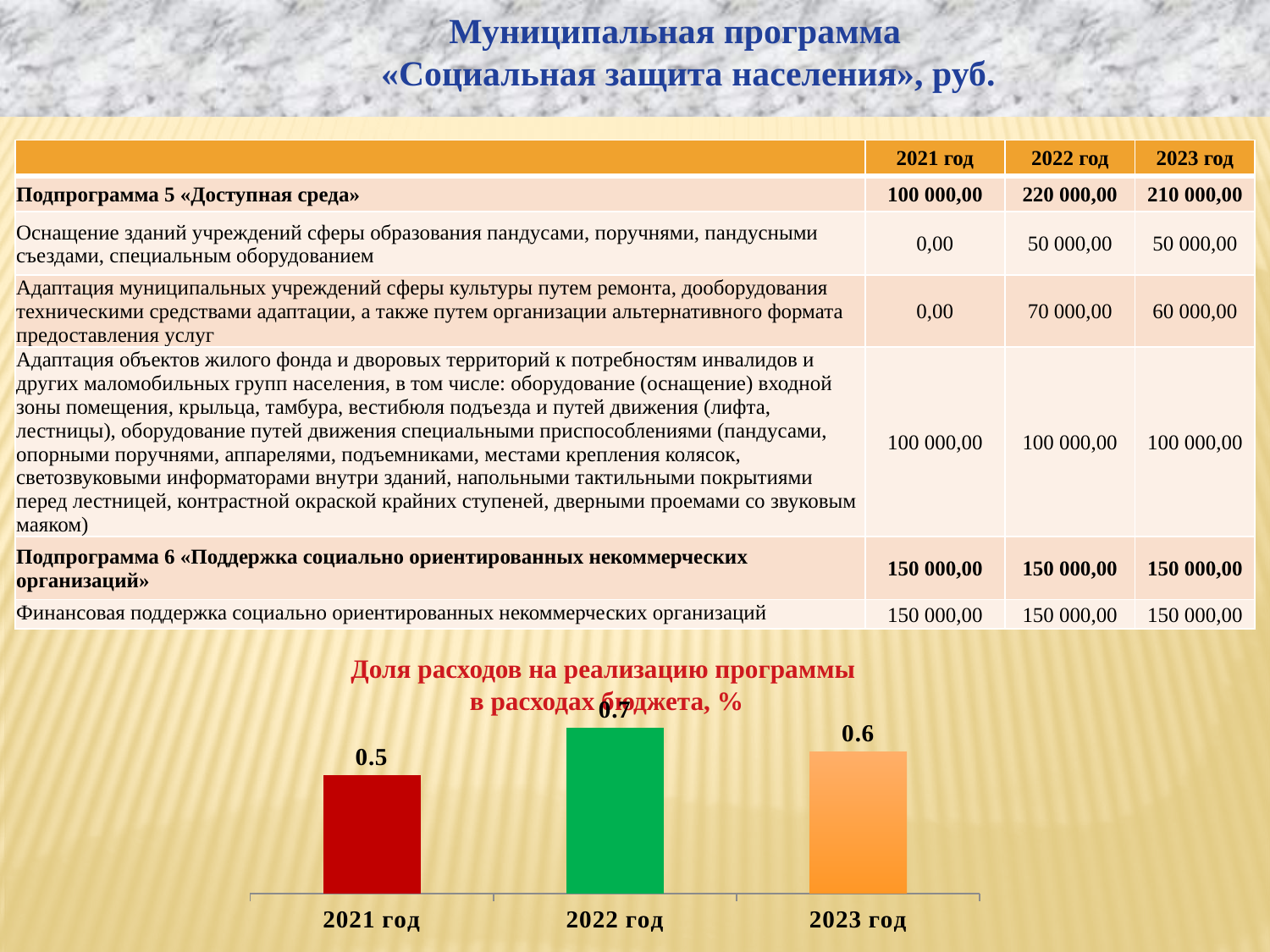
What is the value for 2023 год in the chart? 0.6 Which is larger in the chart, the value for 2023 год or the value for 2021 год? 2023 год Does the value rise or fall from 2022 год to 2023 год in the chart? fall Which year has the highest value in the chart? 2022 год Which year has the lowest value in the chart? 2021 год What is the title of the chart? Доля расходов на реализацию программы в расходах бюджета, % What is the value for 2021 год in the chart? 0.5 What is the difference between the values for 2022 год and 2023 год in the chart? 0.1 What kind of chart is shown on the slide? bar chart How many bars are shown in the chart? 3 What is the value for 2022 год in the chart? 0.7 What is the difference between the values for 2022 год and 2021 год in the chart? 0.2